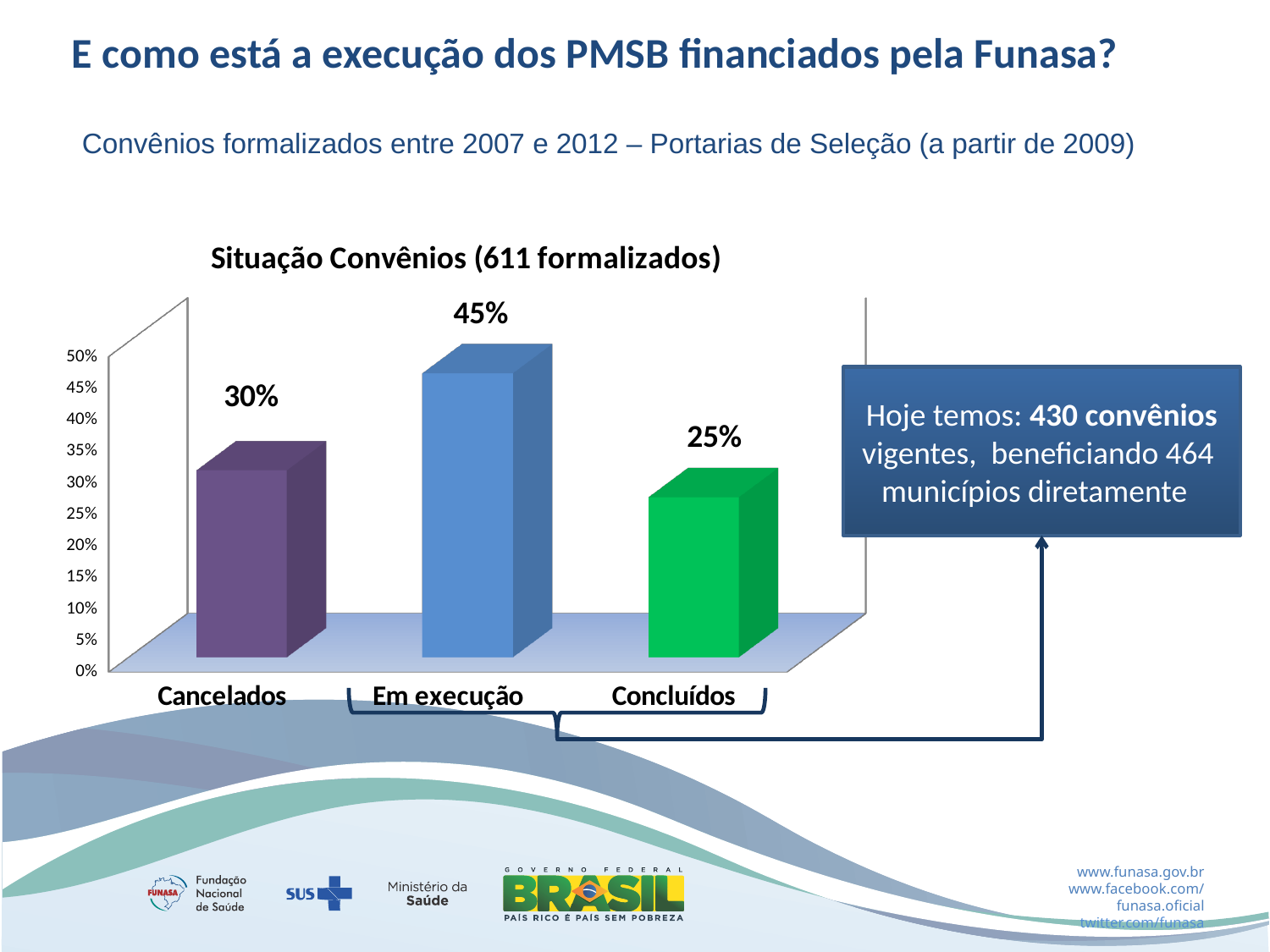
What is the difference between the values for Cancelados and Concluídos? 5% Which category has the lowest value? Concluídos What is the value for Em execução? 45% Which category has the highest value? Em execução Which is larger, the value for Cancelados or the value for Em execução? Em execução How many categories are shown in the chart? 3 What is the value for Concluídos? 25% What is the title of the chart? Situação Convênios (611 formalizados) Is the value for Em execução greater or less than 40%? greater What is the value for Cancelados? 30% What is the difference between the values for Em execução and Concluídos? 20% What kind of chart is shown on the slide? bar chart